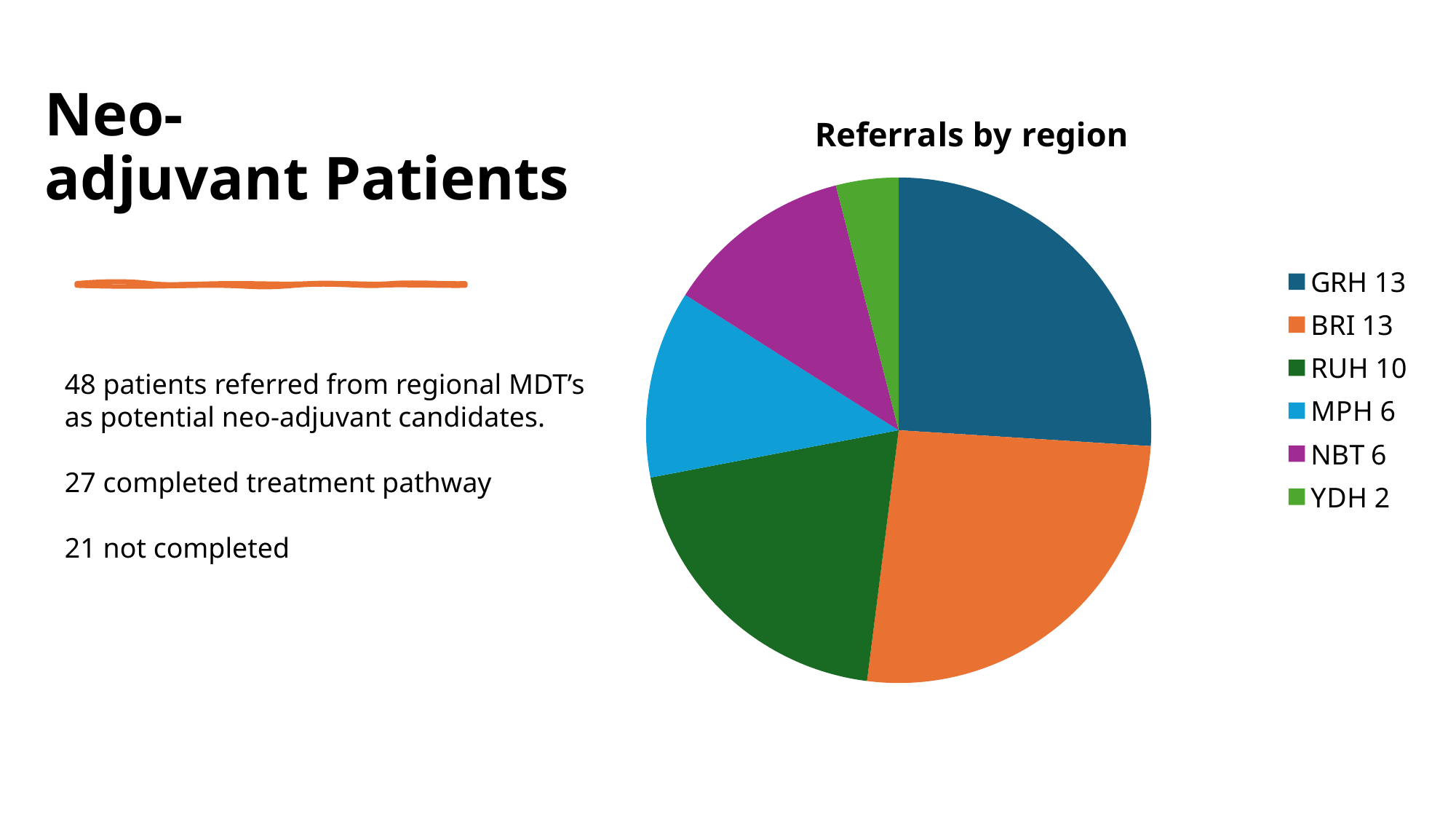
How many regions are shown in the Referrals by region pie chart? 6 What is the title of the chart on the slide? Referrals by region Which has more referrals, BRI or NBT? BRI How many referrals does the legend show for YDH? 2 Which region has the fewest referrals in the pie chart? YDH What is the value for RUH in the Referrals by region chart? 10 What is the total number of referrals across all regions in the pie chart? 50 What is the difference between the referrals for GRH and RUH? 3 What is the value for NBT in the pie chart? 6 Which has more referrals, RUH or MPH? RUH What is the difference between the referrals for MPH and YDH? 4 What type of chart is used to show Referrals by region? Pie chart